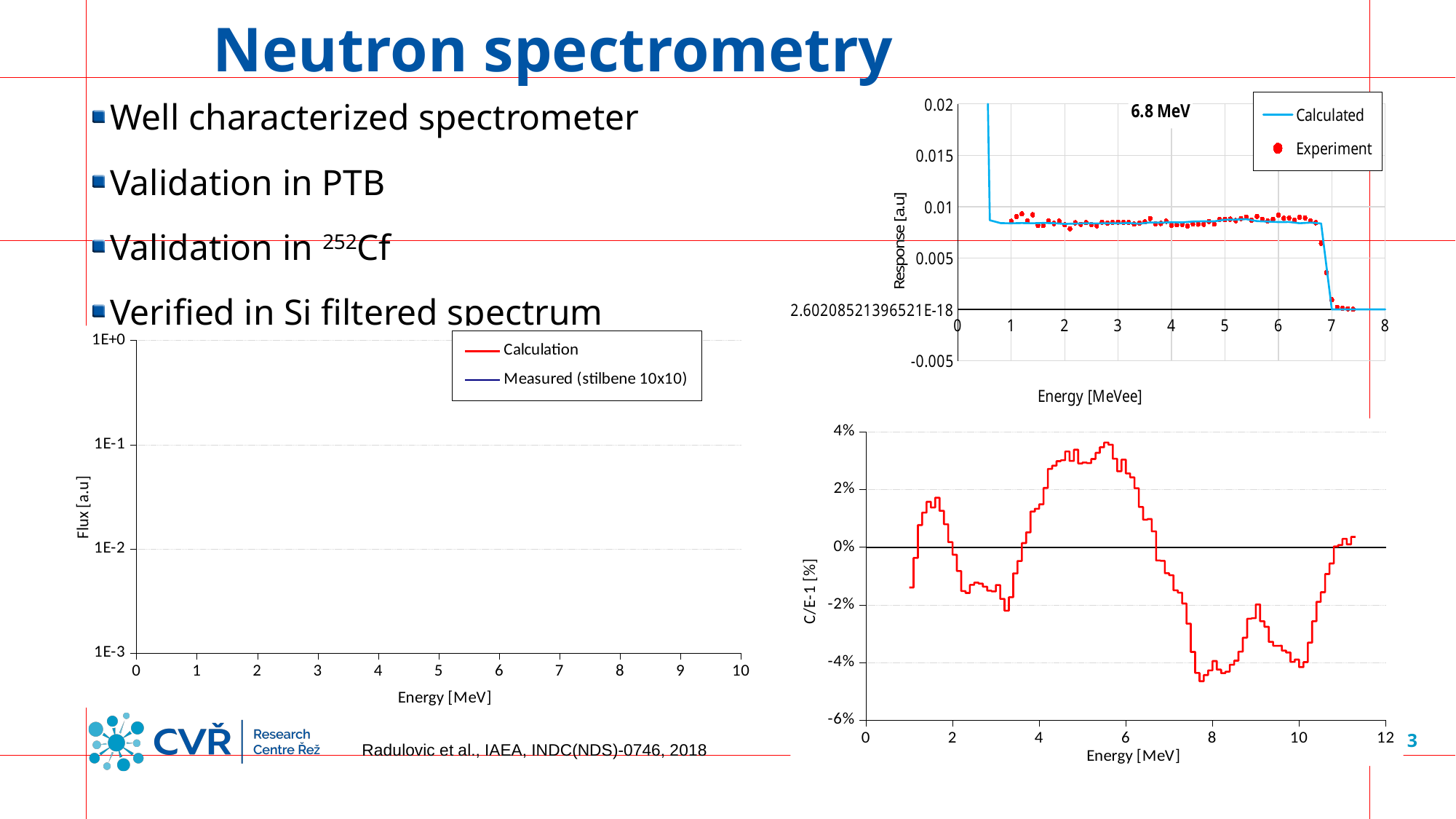
In the top-right chart, is the Calculated response at an energy of 7.5 MeVee greater or less than 0.005? less In the top-right chart, how many series does the legend list? 2 In the bottom-right chart, is the C/E-1 value at an energy of 5.5 MeV greater or less than 2%? greater In the top-right chart, what is the label on the y-axis? Response [a.u] What kind of chart is the bottom-right chart (C/E-1 [%] vs Energy)? line chart In the top-right chart, is the Calculated response at an energy of 3 MeVee greater or less than 0.01? less In the top-right chart, what are the two legend entries? Calculated and Experiment In the bottom-left chart (Flux vs Energy), what is the label on the x-axis? Energy [MeV] In the bottom-left chart (Flux vs Energy), how many series does the legend list? 2 In the top-right chart, does the Calculated response rise or fall between energies of 6.5 and 7.5 MeVee? fall In the bottom-right chart, does the C/E-1 value rise or fall between energies of 6 and 7.5 MeV? fall